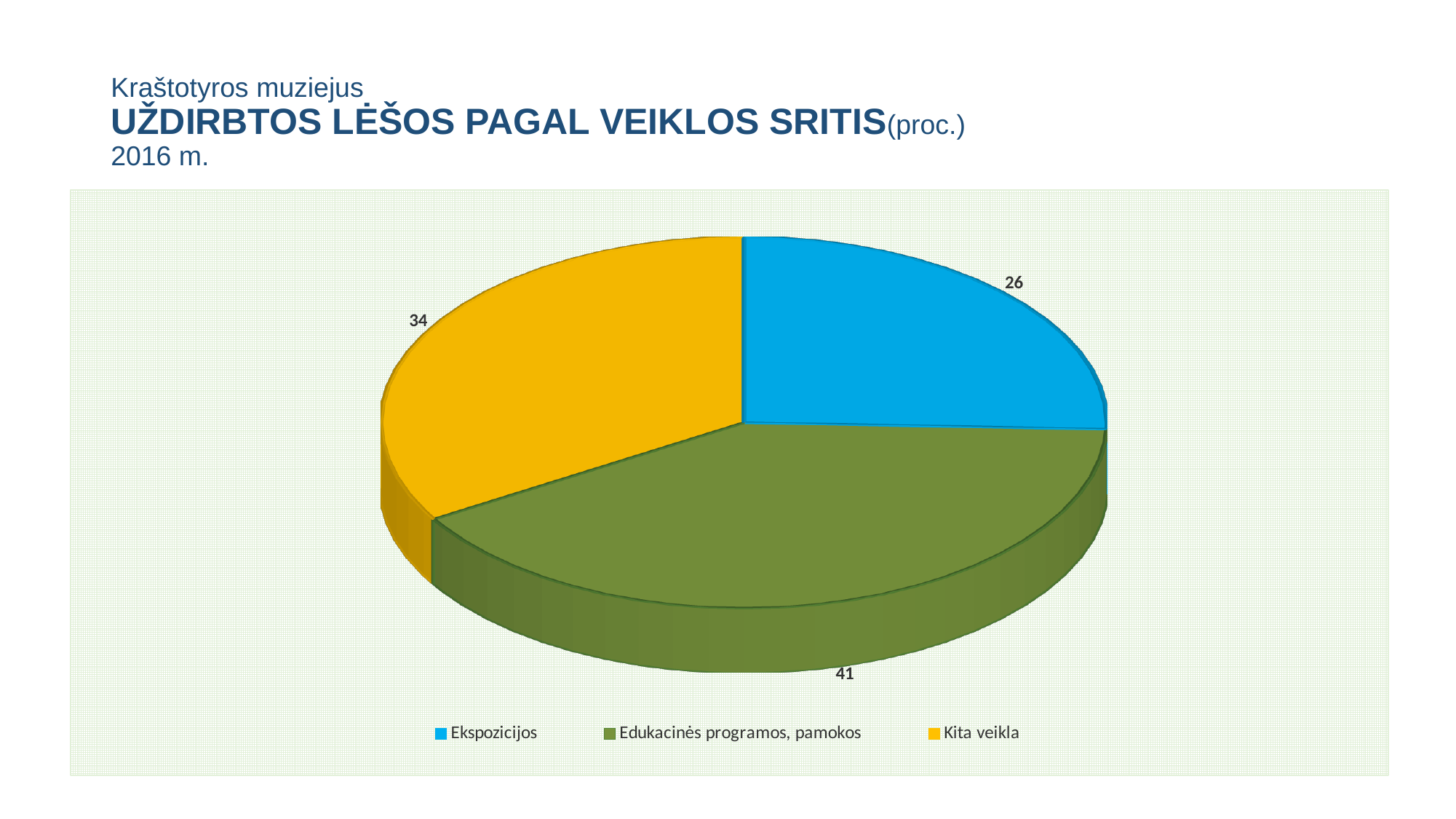
Which category has the smallest share of the pie? Ekspozicijos What is the difference between the values for Edukacinės programos, pamokos and Ekspozicijos? 15 What is the difference between the values for Kita veikla and Ekspozicijos? 8 What is the value for Edukacinės programos, pamokos? 41 Which colour represents Kita veikla in the chart? yellow Which is larger, the value for Kita veikla or the value for Ekspozicijos? Kita veikla What year does the chart title refer to? 2016 m. How many categories does the pie chart have? 3 Which category has the largest share of the pie? Edukacinės programos, pamokos What is the value for Kita veikla? 34 What type of chart is shown on the slide? pie chart What is the value for Ekspozicijos? 26